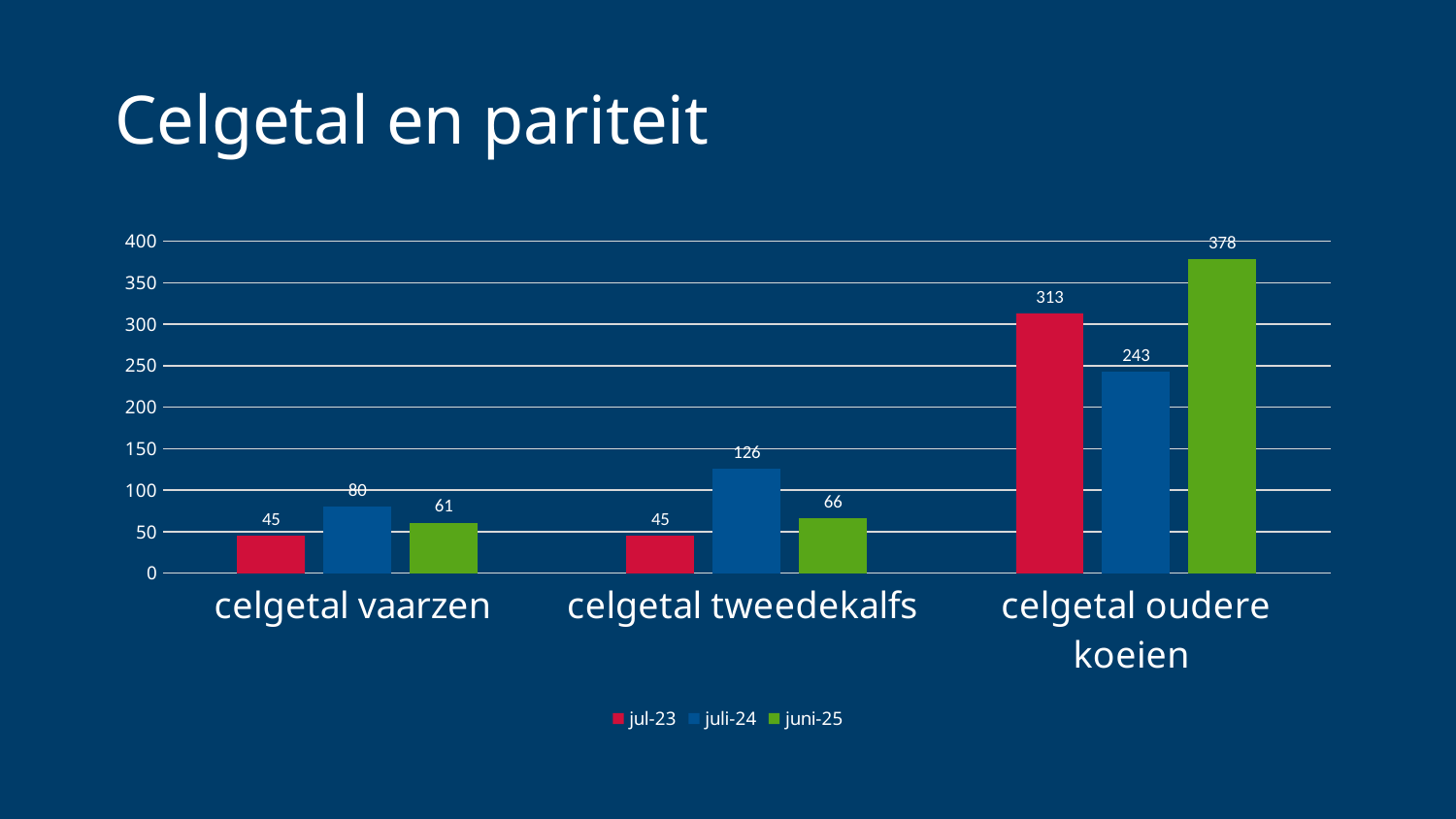
What is the title of the slide? Celgetal en pariteit What is the difference between the juni-25 and jul-23 values for celgetal oudere koeien? 65 What is the value for celgetal tweedekalfs in the juli-24 series? 126 Is the juli-24 value for celgetal oudere koeien greater or less than 200? greater Which series has the lowest value for celgetal oudere koeien? juli-24 What is the value for celgetal vaarzen in the jul-23 series? 45 What kind of chart is shown on the slide? bar chart How many series does the legend list? 3 What is the value for celgetal oudere koeien in the juni-25 series? 378 Which category has the highest value in the jul-23 series? celgetal oudere koeien Which is larger for celgetal tweedekalfs: the juli-24 value or the juni-25 value? juli-24 How many categories are shown on the x axis? 3